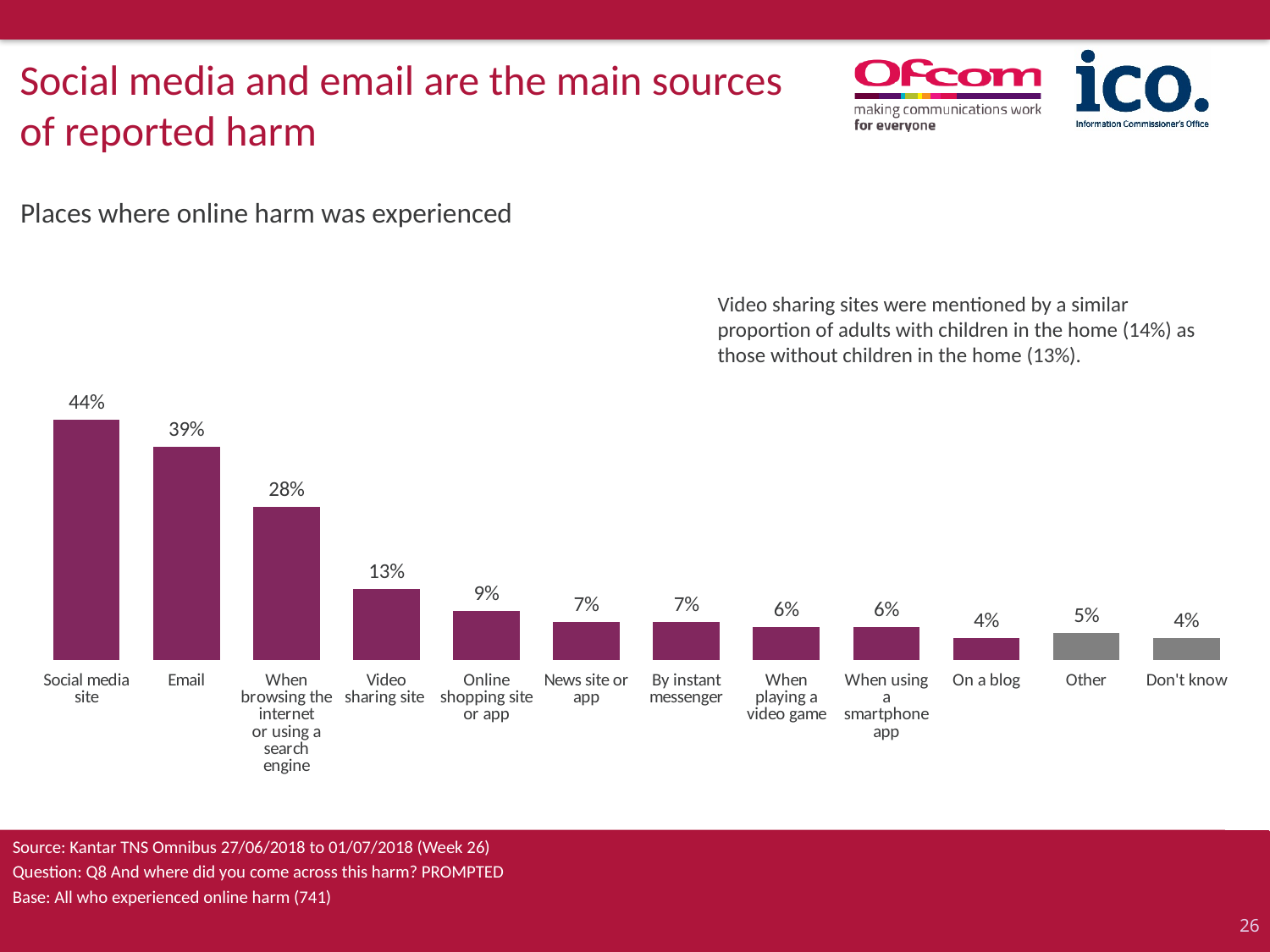
Which two categories are shown in grey rather than purple? Other and Don't know How many categories are shown in the chart? 12 Which category has the highest value in the chart? Social media site What is the value for 'Video sharing site'? 13% Which is larger, the value for 'Online shopping site or app' or the value for 'News site or app'? Online shopping site or app What is the difference between the values for Social media site and Email? 5 percentage points What is the value shown for Email? 39% What is the difference between the values for 'Video sharing site' and 'On a blog'? 9 percentage points What percentage of respondents experienced online harm on a social media site? 44% Do the values generally rise or fall from left to right across the chart? Fall What kind of chart is shown on the slide? Bar chart What percentage is shown for 'When browsing the internet or using a search engine'? 28%